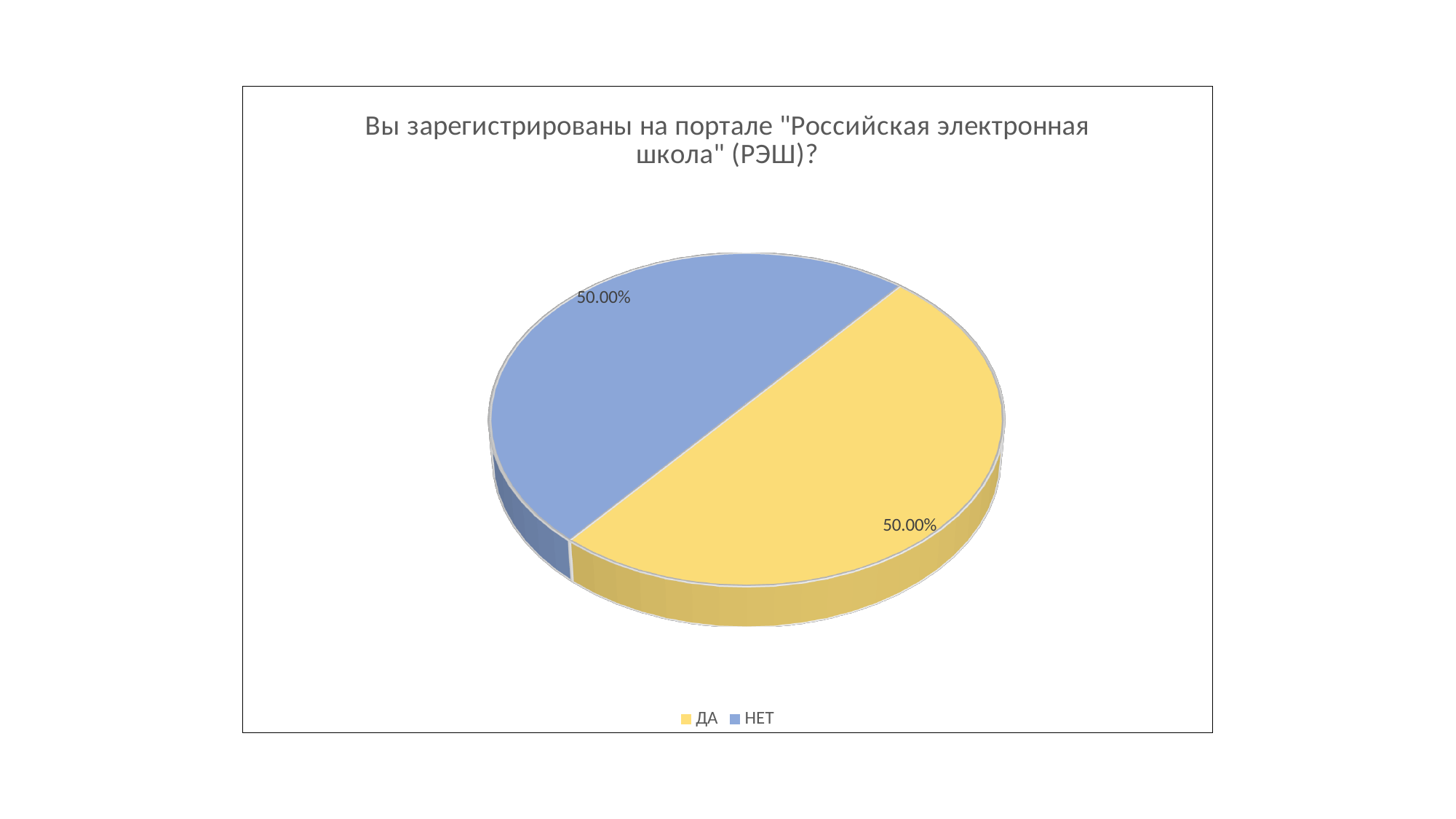
What is the value shown for ДА? 50.00% How many slices does the pie chart have? 2 What is the difference between the values for ДА and НЕТ? 0.00% What share of the pie does the ДА slice represent? 50.00% Is the value for НЕТ greater or less than 40%? greater What is the value shown for НЕТ? 50.00% What kind of chart is shown on the slide? pie chart What is the title of the chart? Вы зарегистрированы на портале "Российская электронная школа" (РЭШ)? How many entries does the legend list? 2 Which colour represents ДА in the chart? yellow